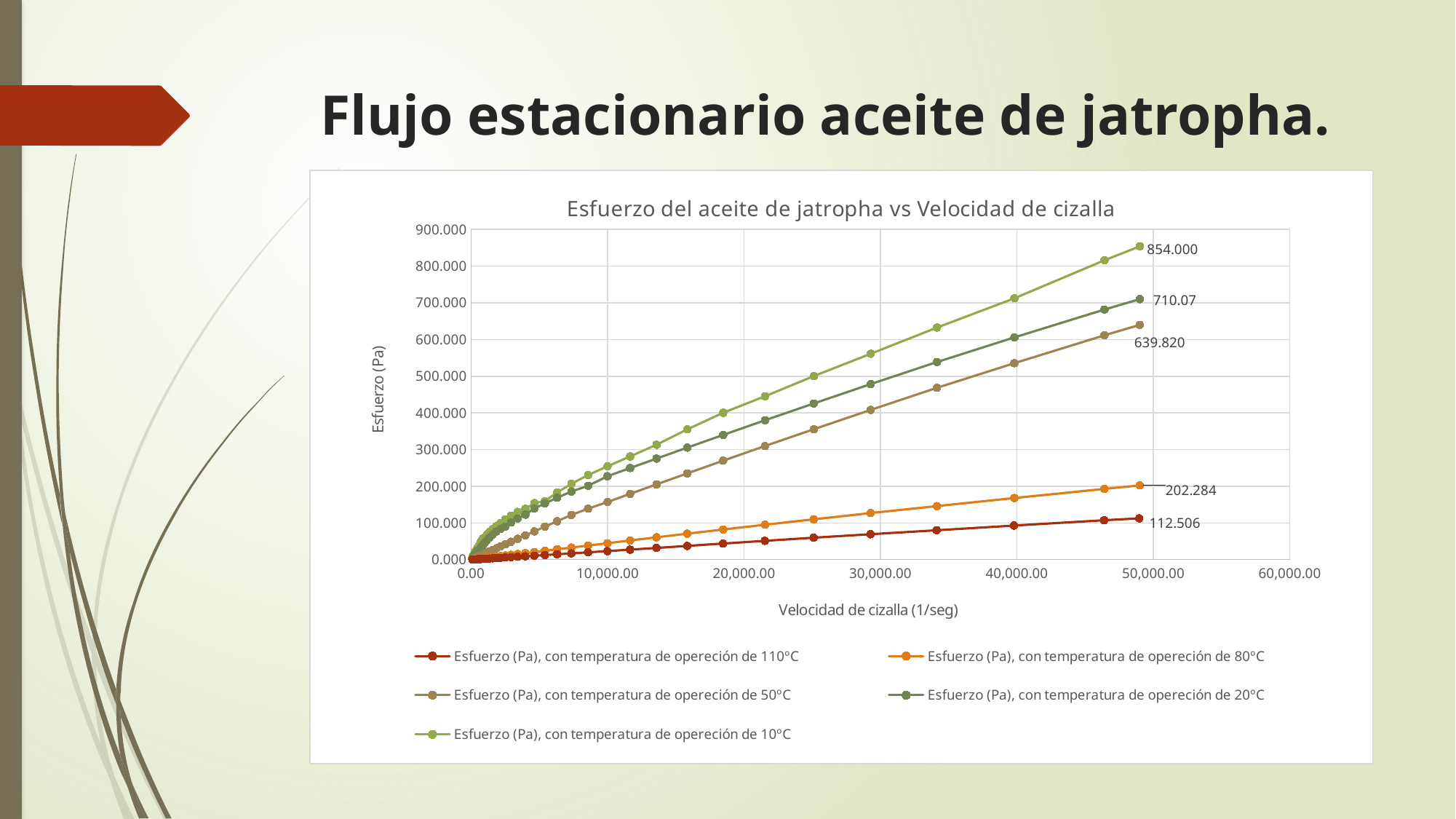
What is the final labelled value for the series with operating temperature of 10°C? 854.000 What is the final labelled value for the series with operating temperature of 20°C? 710.07 What is the difference between the final labelled values of the 10°C series and the 110°C series? 741.494 What type of chart is shown on the slide? line chart What is the final labelled value for the series with operating temperature of 50°C? 639.820 Which series has the lowest stress value at the end of the curves? Esfuerzo (Pa), con temperatura de opereción de 110°C Which series reaches the highest stress value at the end of the curves? Esfuerzo (Pa), con temperatura de opereción de 10°C What is the final labelled value for the series with operating temperature of 80°C? 202.284 Do the stress values rise or fall as shear rate increases along the x axis? rise How many series does the legend list? 5 What is the title of the chart? Esfuerzo del aceite de jatropha vs Velocidad de cizalla What is the final labelled value for the series with operating temperature of 110°C? 112.506